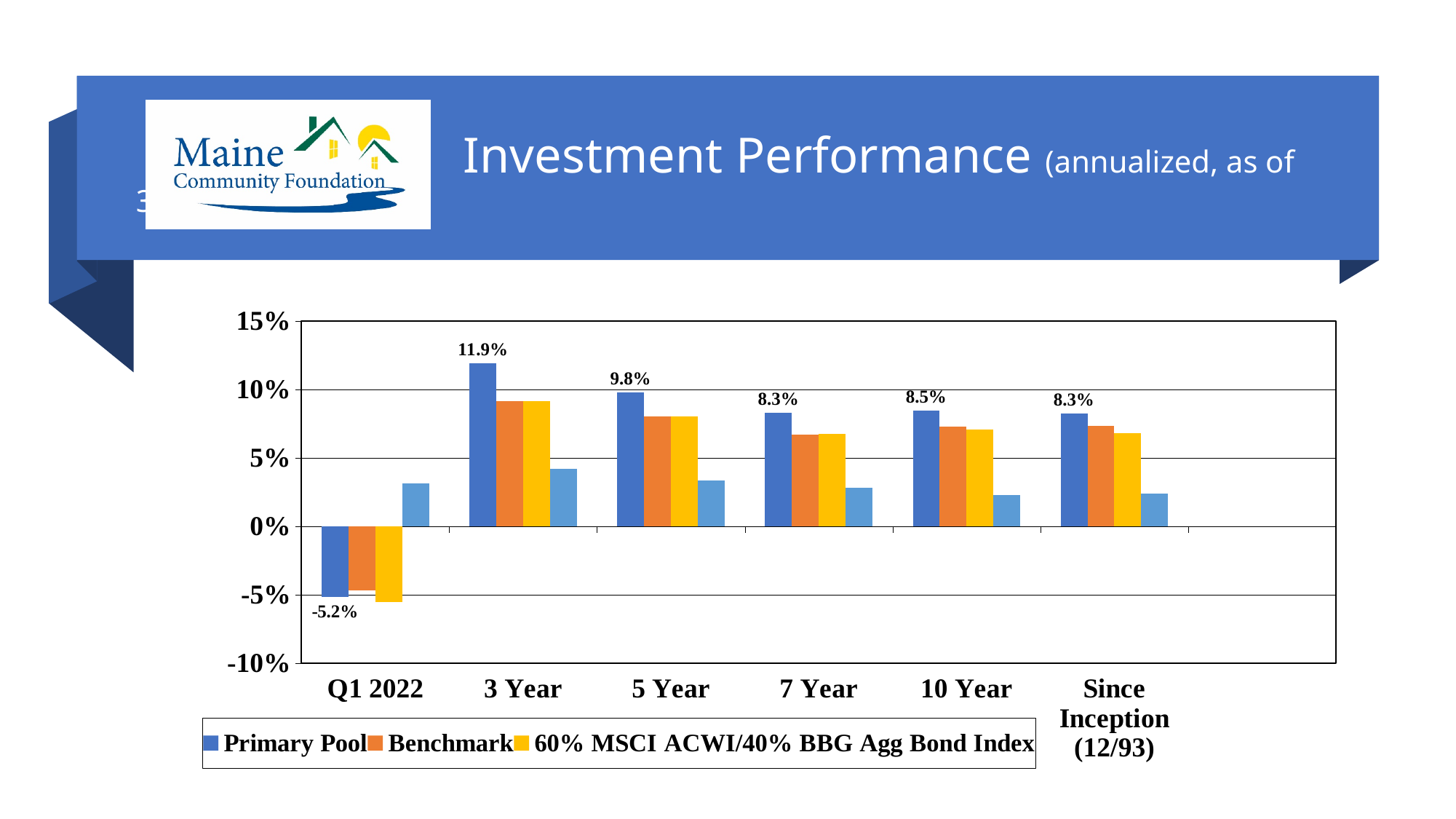
Which is larger, the Primary Pool value for 7 Year or for 10 Year? 10 Year What is the Primary Pool value for Q1 2022? -5.2% What is the Primary Pool value for the 3 Year period? 11.9% Which period has the highest Primary Pool value? 3 Year Is the Benchmark value for the 3 Year period greater or less than 5%? greater Which period has the lowest Primary Pool value? Q1 2022 How many series does the legend list? 3 What is the Primary Pool value for the 10 Year period? 8.5% What is the Primary Pool value for the 5 Year period? 9.8% What kind of chart is shown on the slide? bar chart What is the difference between the Primary Pool values for the 3 Year and 5 Year periods? 2.1 percentage points How many time periods are shown on the x axis? 6